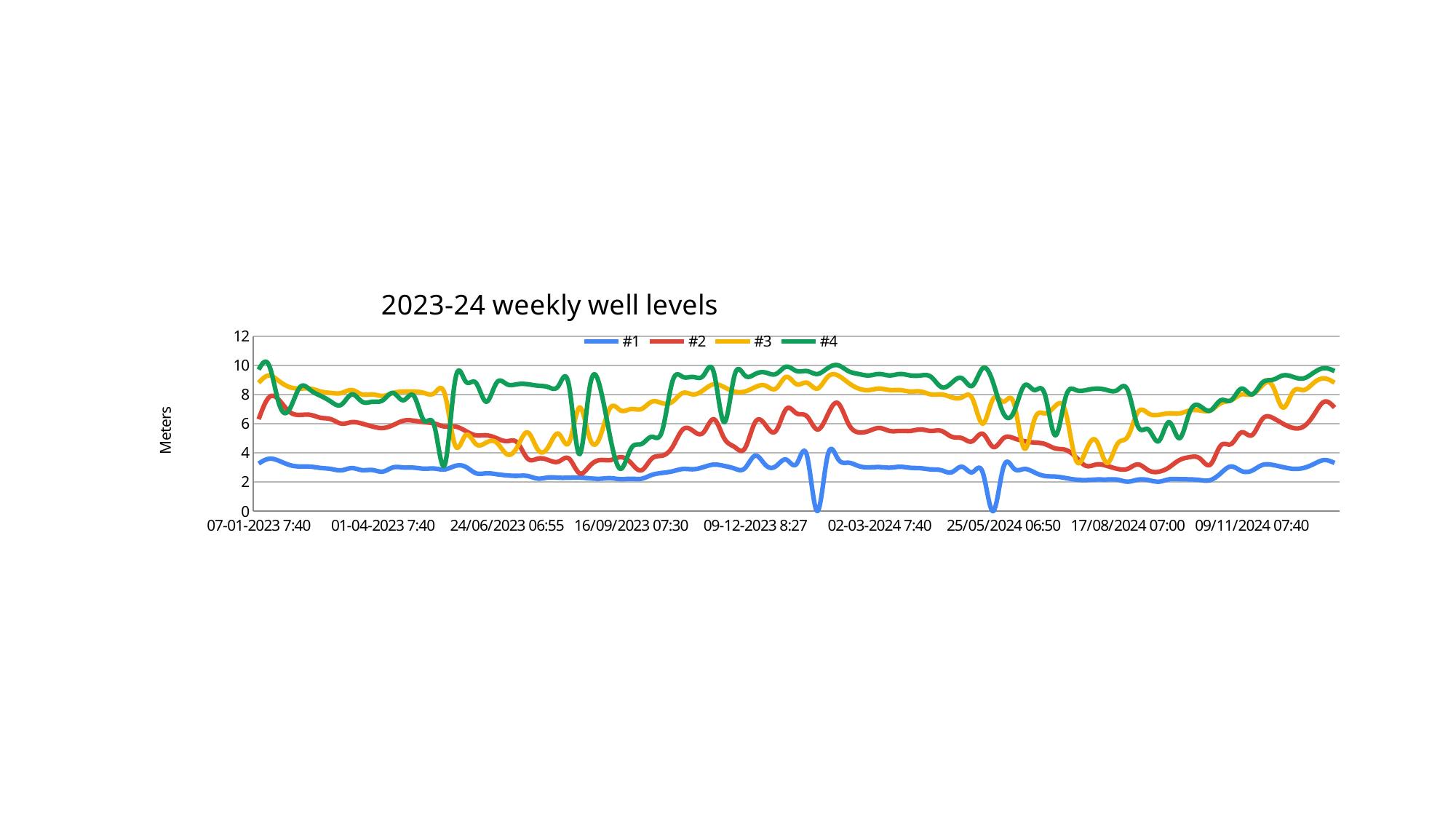
Is the value for #4 at 07-01-2023 7:40 greater or less than 8? greater Is the value for #2 at 09-12-2023 8:27 greater or less than 8? less Which series has the lowest values across the whole chart? #1 How many series does the legend list? 4 What is the label on the vertical axis? Meters What kind of chart is shown on the slide? line chart Is the value for #3 at 02-03-2024 7:40 greater or less than 6? greater At 07-01-2023 7:40, which series has the higher value, #1 or #4? #4 What is the title of the chart? 2023-24 weekly well levels Does the #4 line rise or fall from 09/11/2024 07:40 to the end of the chart? rise At 17/08/2024 07:00, which series has the higher value, #2 or #4? #4